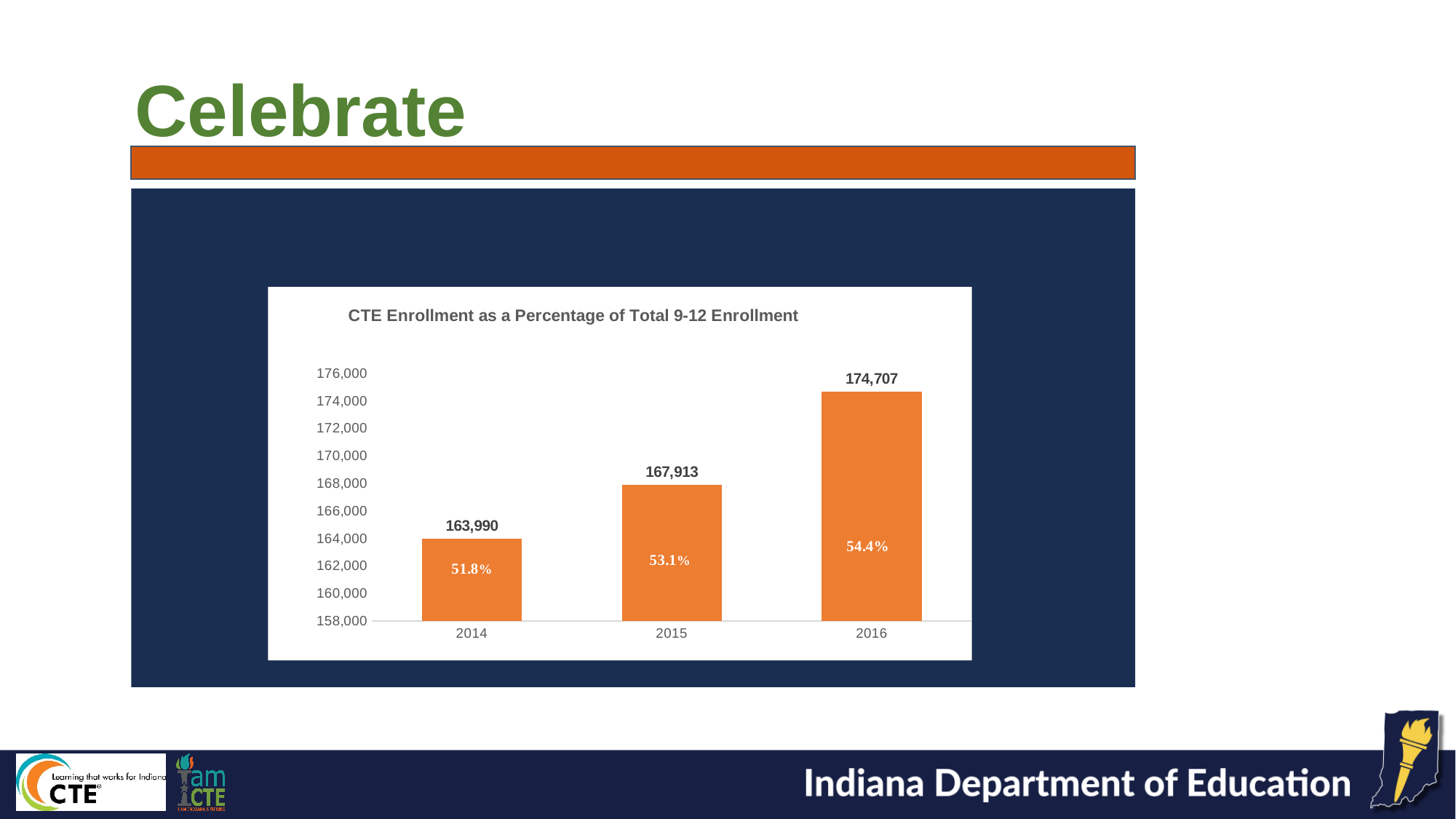
What is the difference in CTE enrollment between 2016 and 2015? 6,794 What is the difference in CTE enrollment between 2015 and 2014? 3,923 What is the CTE enrollment value shown for 2016? 174,707 How many years are shown on the x axis of the chart? 3 Which year has the lowest CTE enrollment? 2014 What is the CTE enrollment value shown for 2014? 163,990 Do the CTE enrollment values rise or fall from 2014 to 2016? Rise What percentage label is shown inside the 2016 bar? 54.4% Which year has a larger CTE enrollment, 2014 or 2015? 2015 What kind of chart is shown on the slide? Bar chart Which year has the highest CTE enrollment? 2016 What percentage label is shown inside the 2015 bar? 53.1%